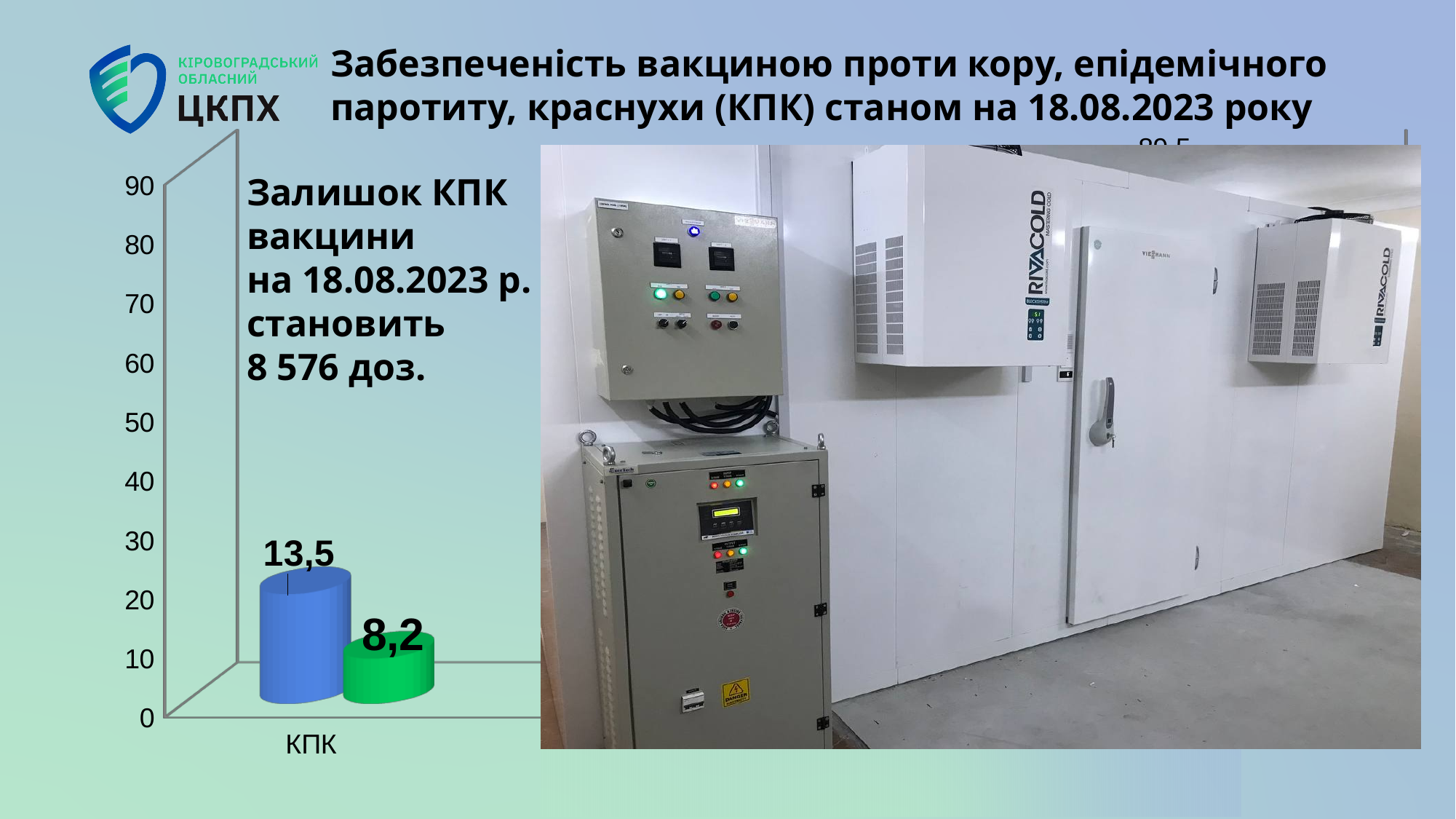
What value is labelled on the blue bar in the chart? 13,5 What is the category label shown on the x axis of the chart? КПК Is the value of the blue bar greater or less than 20? less According to the text on the slide, how many doses of КПК vaccine remained on 18.08.2023? 8 576 доз What is the difference between the blue bar value (13,5) and the green bar value (8,2)? 5,3 Which is larger, the blue bar or the green bar? the blue bar What value is labelled on the green bar in the chart? 8,2 What kind of chart is shown on the slide? bar chart What is the highest tick value shown on the vertical axis of the chart? 90 Is the value of the green bar greater or less than 10? less